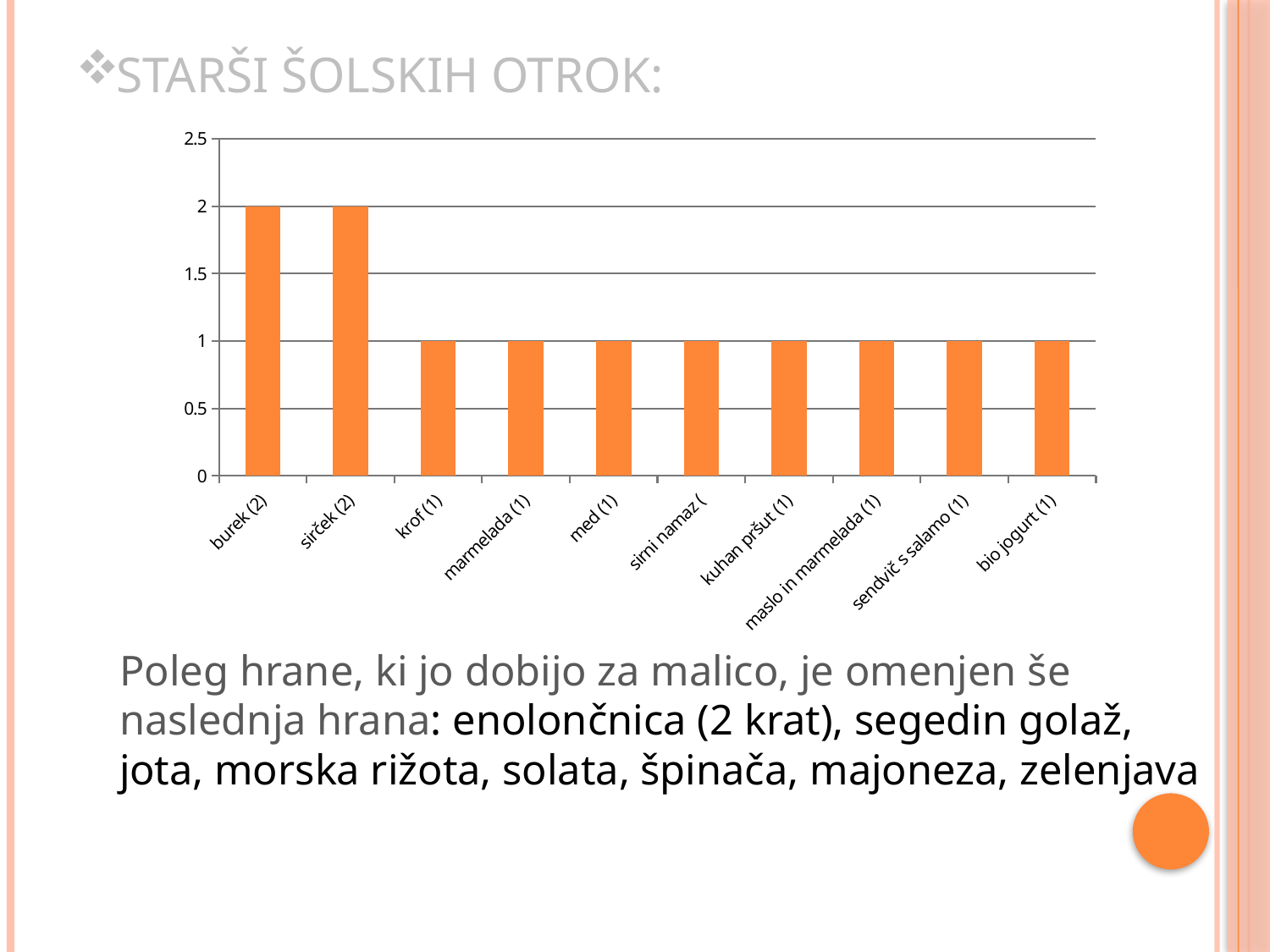
How many categories are plotted on the chart? 10 What is the value for sirček (2) on the chart? 2 What is the difference between the value for sirček (2) and the value for marmelada (1)? 1 Is the value for burek (2) greater or less than 1.5? greater Which is larger on the chart, the value for burek (2) or the value for med (1)? burek (2) What colour are the bars in the chart? orange What is the value for krof (1) on the chart? 1 What kind of chart is shown on the slide? bar chart What is the value for bio jogurt (1) on the chart? 1 What is the highest value shown on the vertical axis of the chart? 2.5 What is the value for burek (2) on the chart? 2 Is the value for kuhan pršut (1) greater or less than 1.5? less